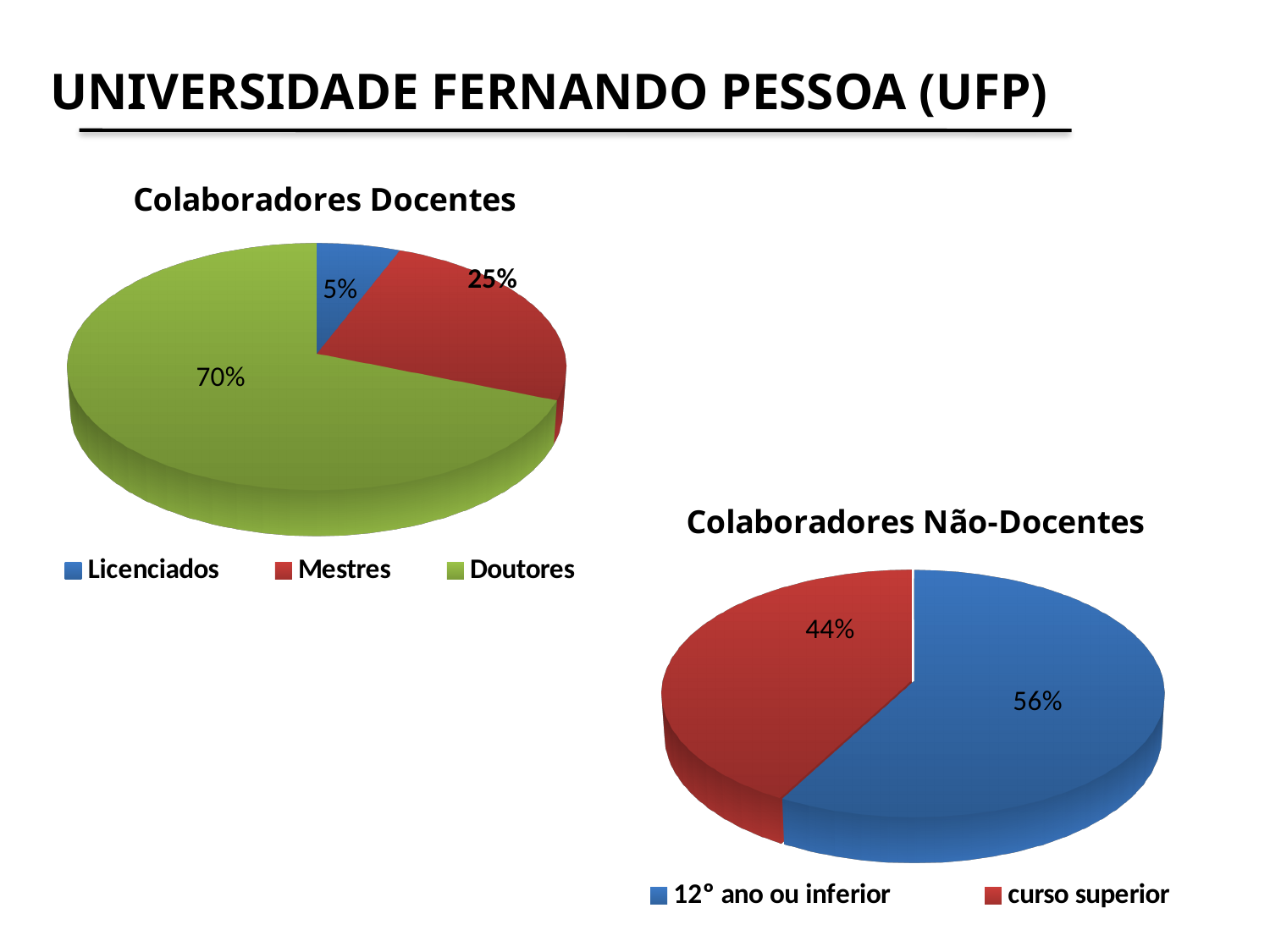
In the 'Colaboradores Docentes' chart, which category has the smallest slice? Licenciados What type of chart is the 'Colaboradores Não-Docentes' chart? Pie chart In the 'Colaboradores Docentes' chart, which category has the largest slice? Doutores In the 'Colaboradores Docentes' chart, what is the difference in percentage points between Doutores and Mestres? 45 In the 'Colaboradores Docentes' chart, what percentage is shown for Licenciados? 5% In the 'Colaboradores Docentes' chart, what percentage is shown for Doutores? 70% In the 'Colaboradores Não-Docentes' chart, what percentage is shown for '12° ano ou inferior'? 56% In the 'Colaboradores Não-Docentes' chart, what percentage is shown for 'curso superior'? 44% In the 'Colaboradores Docentes' chart, how many categories does the legend list? 3 In the 'Colaboradores Não-Docentes' chart, what colour is the 'curso superior' slice? Red In the 'Colaboradores Docentes' chart, what percentage is shown for Mestres? 25% In the 'Colaboradores Não-Docentes' chart, which category is larger, '12° ano ou inferior' or 'curso superior'? 12° ano ou inferior